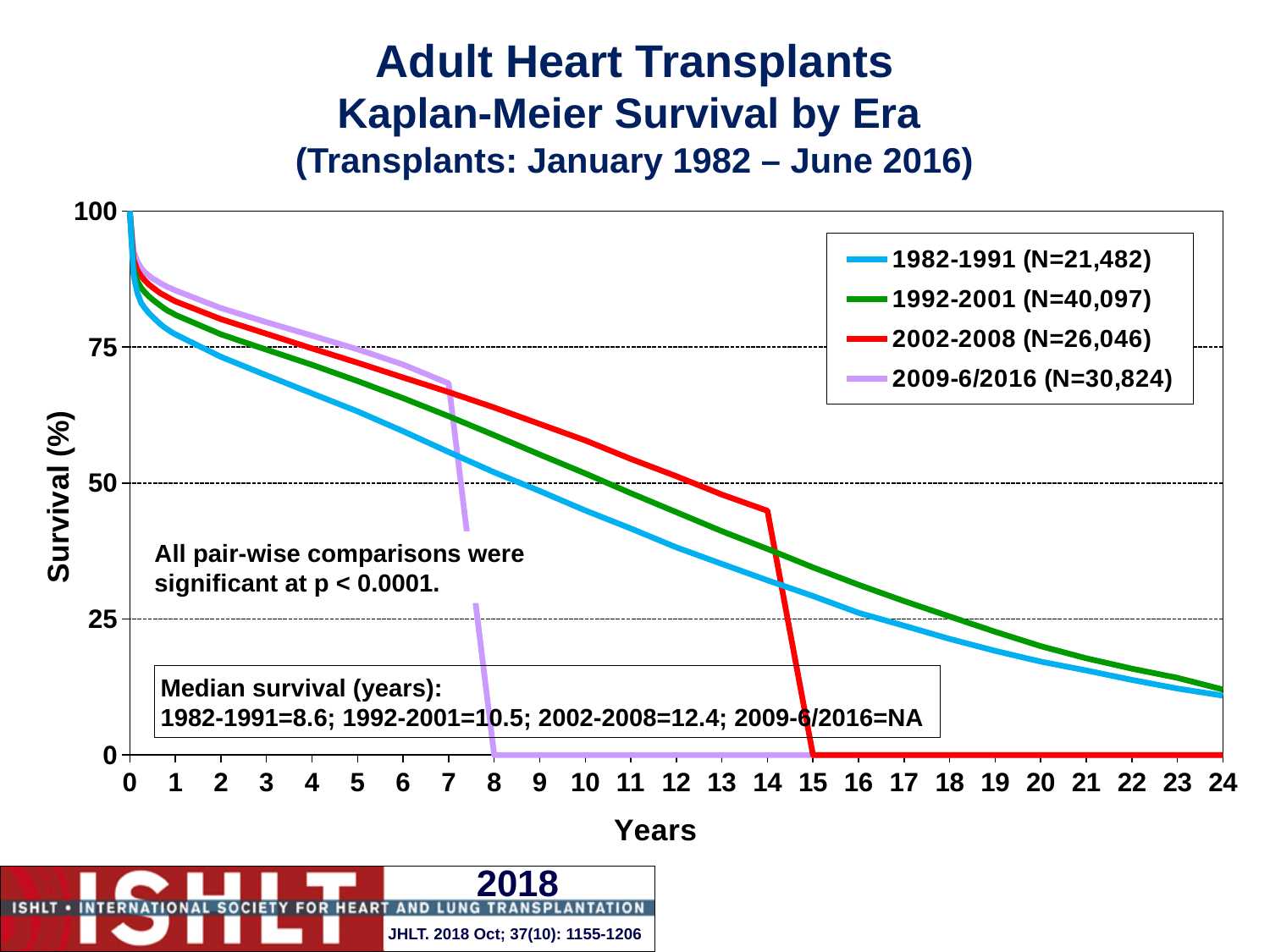
What is the N for the 1992-2001 era shown in the legend? 40,097 How much longer is the median survival for 2002-2008 than for 1982-1991, in years? 3.8 What is the median survival given for the 2009-6/2016 era? NA Is the survival for the 2002-2008 era at 10 years greater or less than 50%? greater Do the survival curves rise or fall as years increase? fall How many eras (series) does the legend list? 4 What is the median survival in years for the 1982-1991 era? 8.6 Which era has the longest median survival among those with a numeric value? 2002-2008 Is the survival for the 1982-1991 era at 10 years greater or less than 50%? less What is the median survival in years for the 2002-2008 era? 12.4 What kind of chart is shown on the slide? line chart